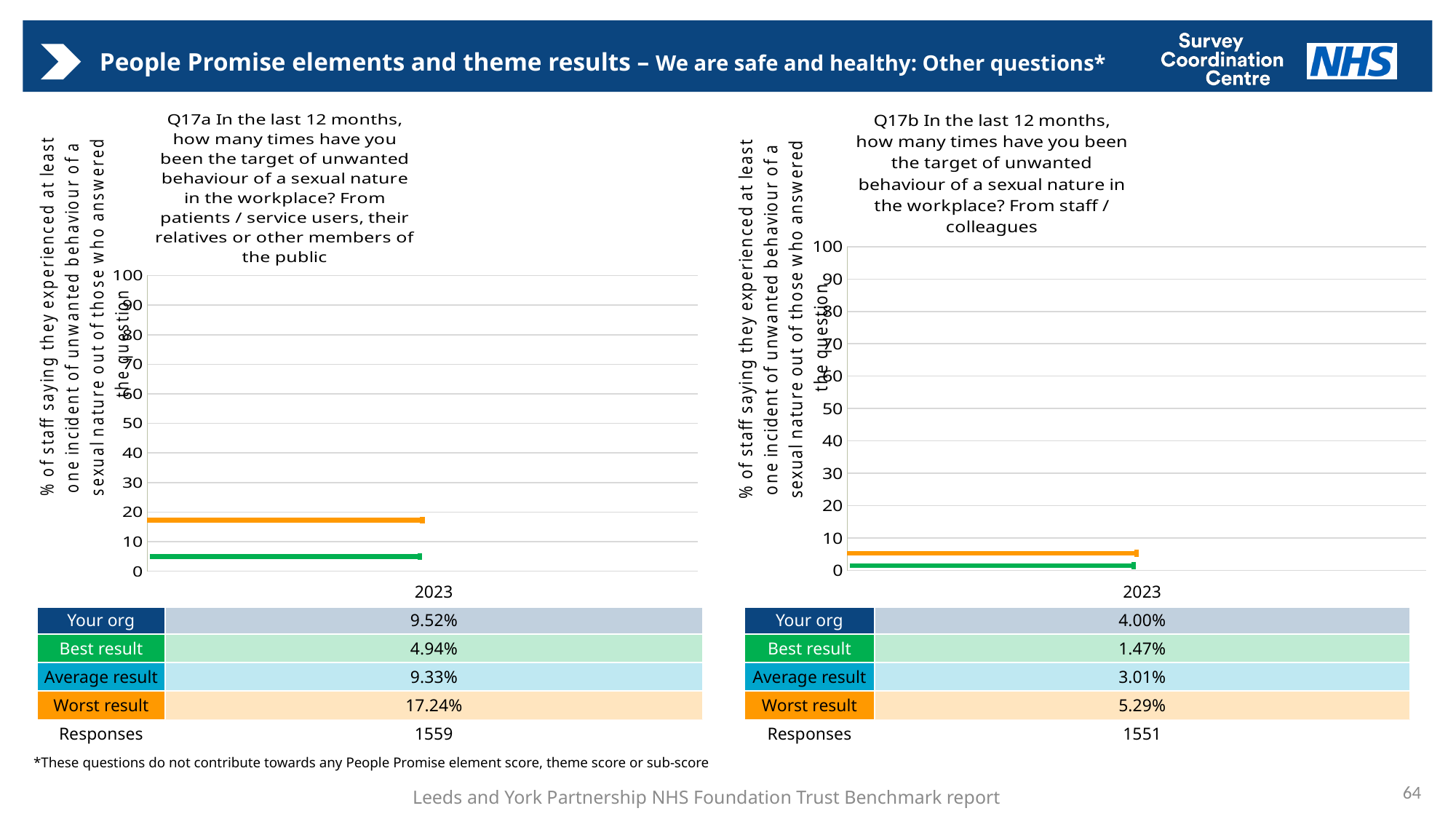
In the Q17b chart (right), how much higher is Your org than the Average result? 0.99% In the Q17a chart (left), what is the value for Your org? 9.52% In the Q17b chart (right), which result has the highest value? Worst result In the Q17a chart (left), how many responses are reported? 1559 In the Q17a chart (left), which is larger: Your org or the Average result? Your org In the Q17a chart (left), what is the Worst result value? 17.24% In the Q17b chart (right), what is the Average result value? 3.01% In the Q17b chart (right), what is the Best result value? 1.47% In the Q17b chart (right), how many responses are reported? 1551 In the Q17b chart (right), how many years are shown on the x axis? 1 In the Q17a chart (left), is the Worst result greater or less than 20? less In the Q17a chart (left), what is the difference between the Worst result and the Best result? 12.30%